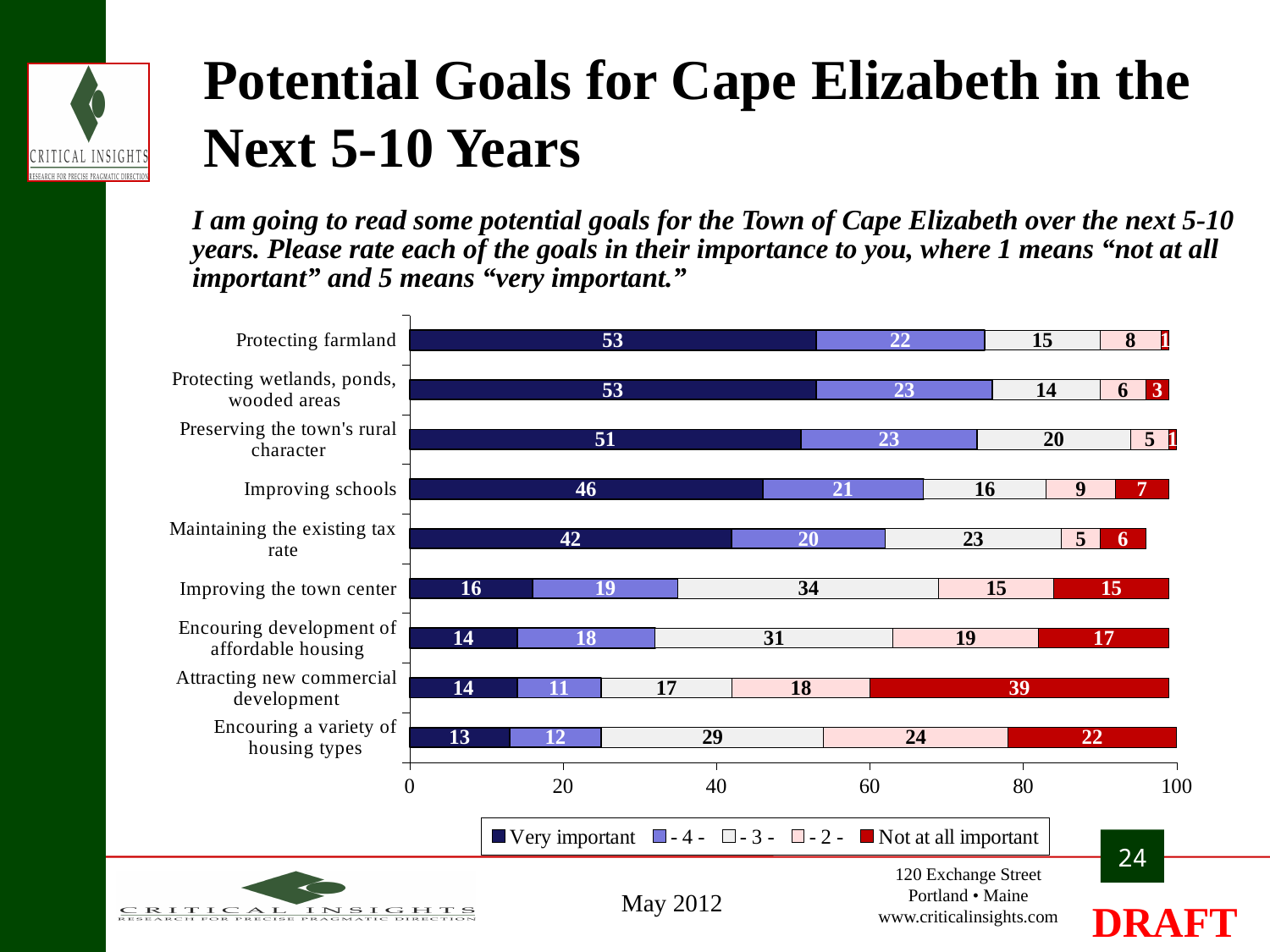
What is the "- 3 -" value for "Improving the town center"? 34 What is the difference between the "Very important" values for "Protecting farmland" and "Maintaining the existing tax rate"? 11 Which goal has the highest "Not at all important" value? Attracting new commercial development How many series does the legend list? 5 What is the total of the stacked bar for "Maintaining the existing tax rate"? 96 What percentage of respondents rated "Improving schools" as very important? 46 How many goals are listed on the chart? 9 What is the "Not at all important" value for "Attracting new commercial development"? 39 Which goal has the lowest "Very important" value? Encouring a variety of housing types What is the maximum value shown on the horizontal axis? 100 What kind of chart is shown on the slide? Stacked bar chart Which has a larger "- 2 -" value: "Encouring a variety of housing types" or "Improving schools"? Encouring a variety of housing types